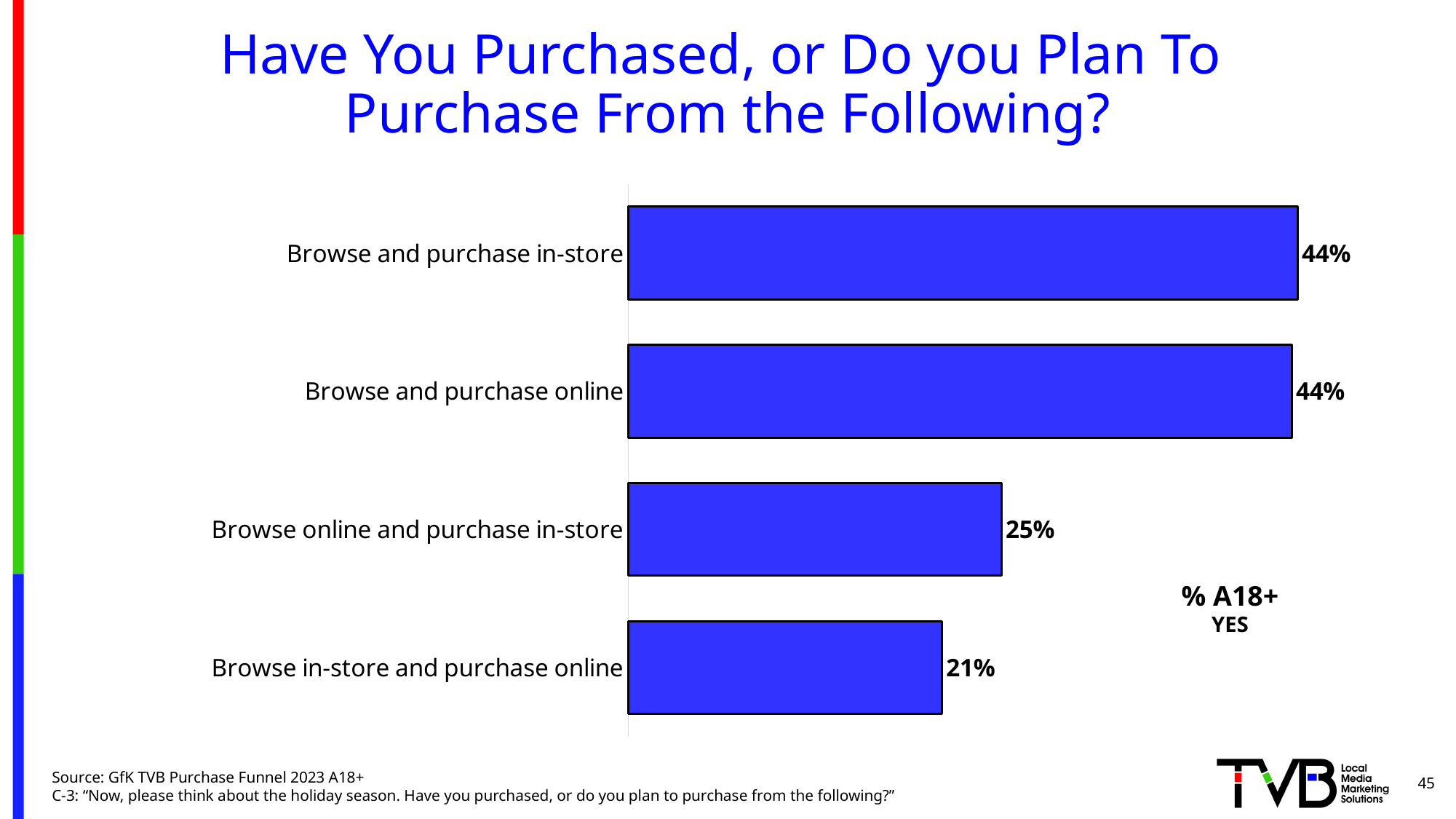
What percentage of A18+ said yes to 'Browse and purchase online'? 44% What percentage of A18+ said yes to 'Browse online and purchase in-store'? 25% What kind of chart is shown on the slide? Bar chart What is the difference in percentage points between 'Browse online and purchase in-store' and 'Browse in-store and purchase online'? 4 Which is larger: the value for 'Browse online and purchase in-store' or the value for 'Browse in-store and purchase online'? Browse online and purchase in-store Which is larger: the value for 'Browse and purchase in-store' or the value for 'Browse online and purchase in-store'? Browse and purchase in-store What percentage of A18+ said yes to 'Browse in-store and purchase online'? 21% What is the title of the slide? Have You Purchased, or Do you Plan To Purchase From the Following? What is the difference in percentage points between 'Browse and purchase online' and 'Browse online and purchase in-store'? 19 How many categories are shown in the chart? 4 Which category has the lowest percentage? Browse in-store and purchase online What percentage of A18+ said yes to 'Browse and purchase in-store'? 44%